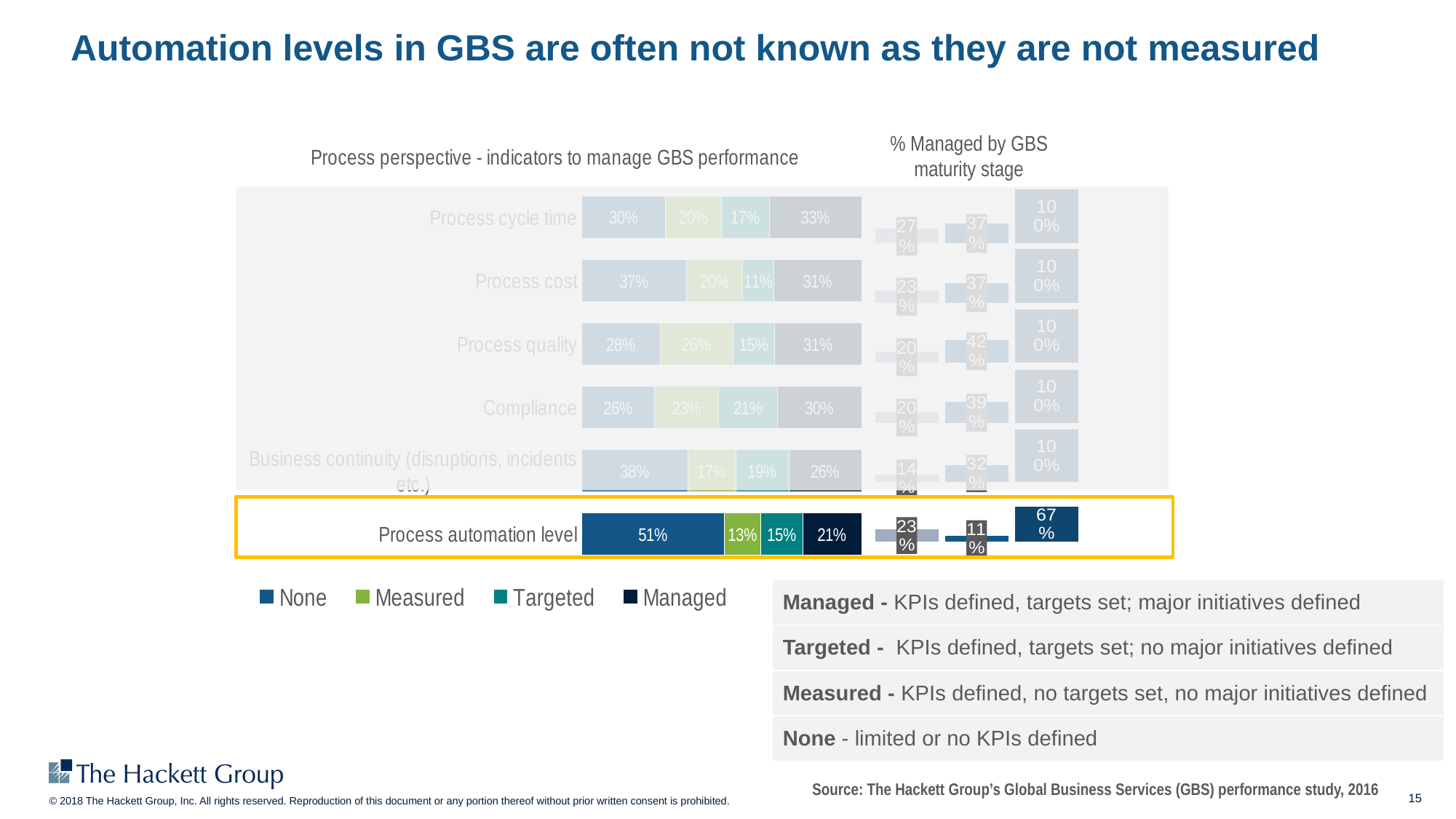
In the 'Process perspective - indicators to manage GBS performance' chart, what is the 'Managed' value for Process cycle time? 33% In the 'Process perspective - indicators to manage GBS performance' chart, which category has the lowest 'Targeted' value? Process cost In the 'Process perspective - indicators to manage GBS performance' chart, what is the total of the stacked bar for Process automation level? 100% How many process categories are shown in the 'Process perspective - indicators to manage GBS performance' chart? 6 In the 'Process perspective - indicators to manage GBS performance' chart, what is the difference between the 'None' and 'Managed' values for Process automation level? 30 percentage points In the 'Process perspective - indicators to manage GBS performance' chart, which has the larger 'Measured' value: Process quality or Compliance? Process quality How many series does the legend of the 'Process perspective - indicators to manage GBS performance' chart list? 4 In the 'Process perspective - indicators to manage GBS performance' chart, which category has the highest 'None' value? Process automation level In the '% Managed by GBS maturity stage' chart, what is the third (rightmost) value for Process automation level? 67% What kind of chart is the 'Process perspective - indicators to manage GBS performance' chart? Stacked bar chart In the 'Process perspective - indicators to manage GBS performance' chart, what is the 'None' value for Process automation level? 51% What are the four legend entries of the 'Process perspective - indicators to manage GBS performance' chart? None, Measured, Targeted, Managed